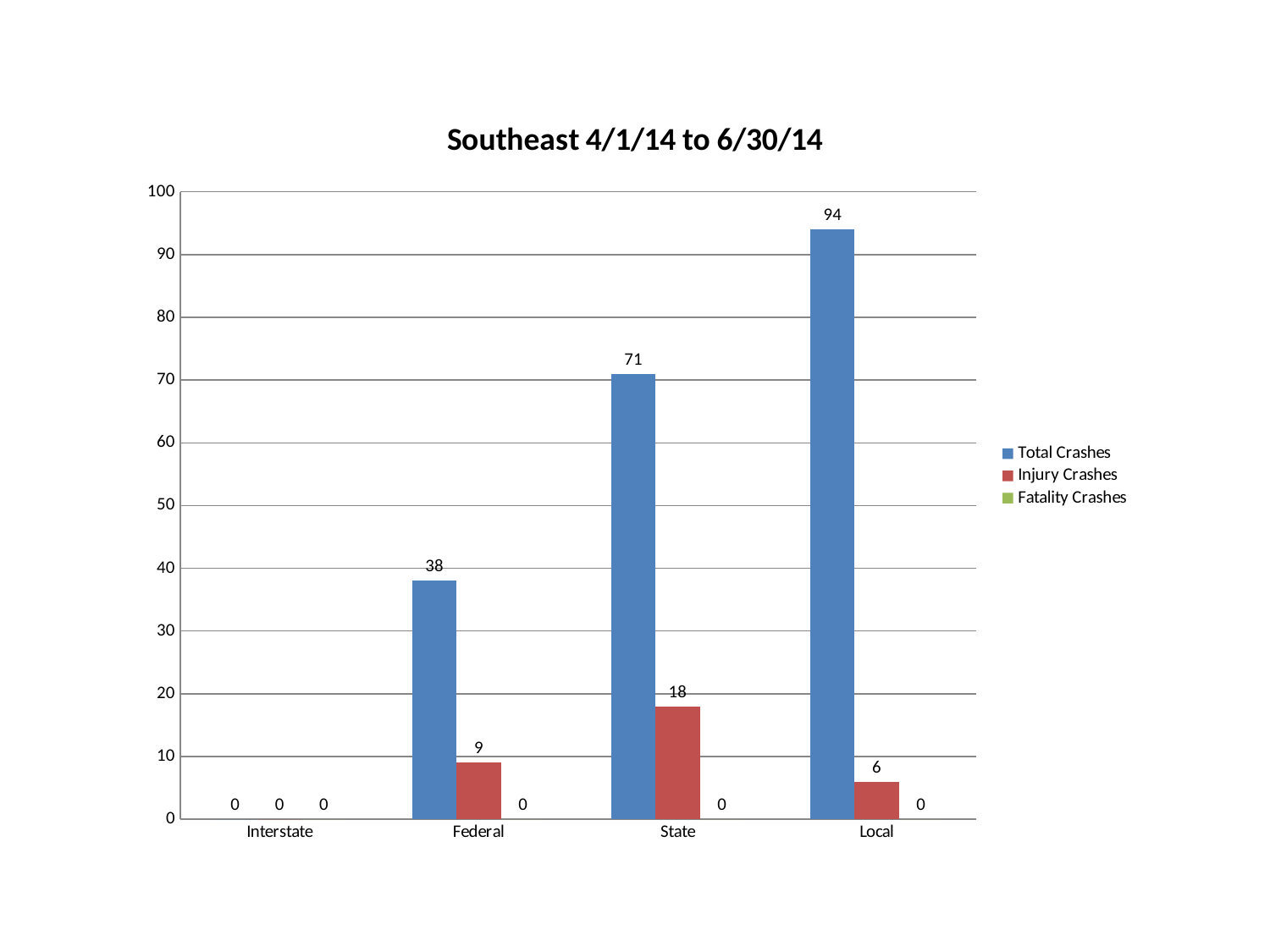
What is the value of Fatality Crashes for Local? 0 What is the value of Injury Crashes for State? 18 What is the value of Total Crashes for Local? 94 What is the title of the chart? Southeast 4/1/14 to 6/30/14 Which category has the lowest Injury Crashes? Interstate How many series does the legend list? 3 What is the difference between Total Crashes for Local and Total Crashes for State? 23 What is the value of Total Crashes for Federal? 38 What kind of chart is shown on the slide? Bar chart Which is larger: Injury Crashes for Federal or Injury Crashes for Local? Injury Crashes for Federal How many categories are shown on the x axis? 4 Which category has the highest Total Crashes? Local